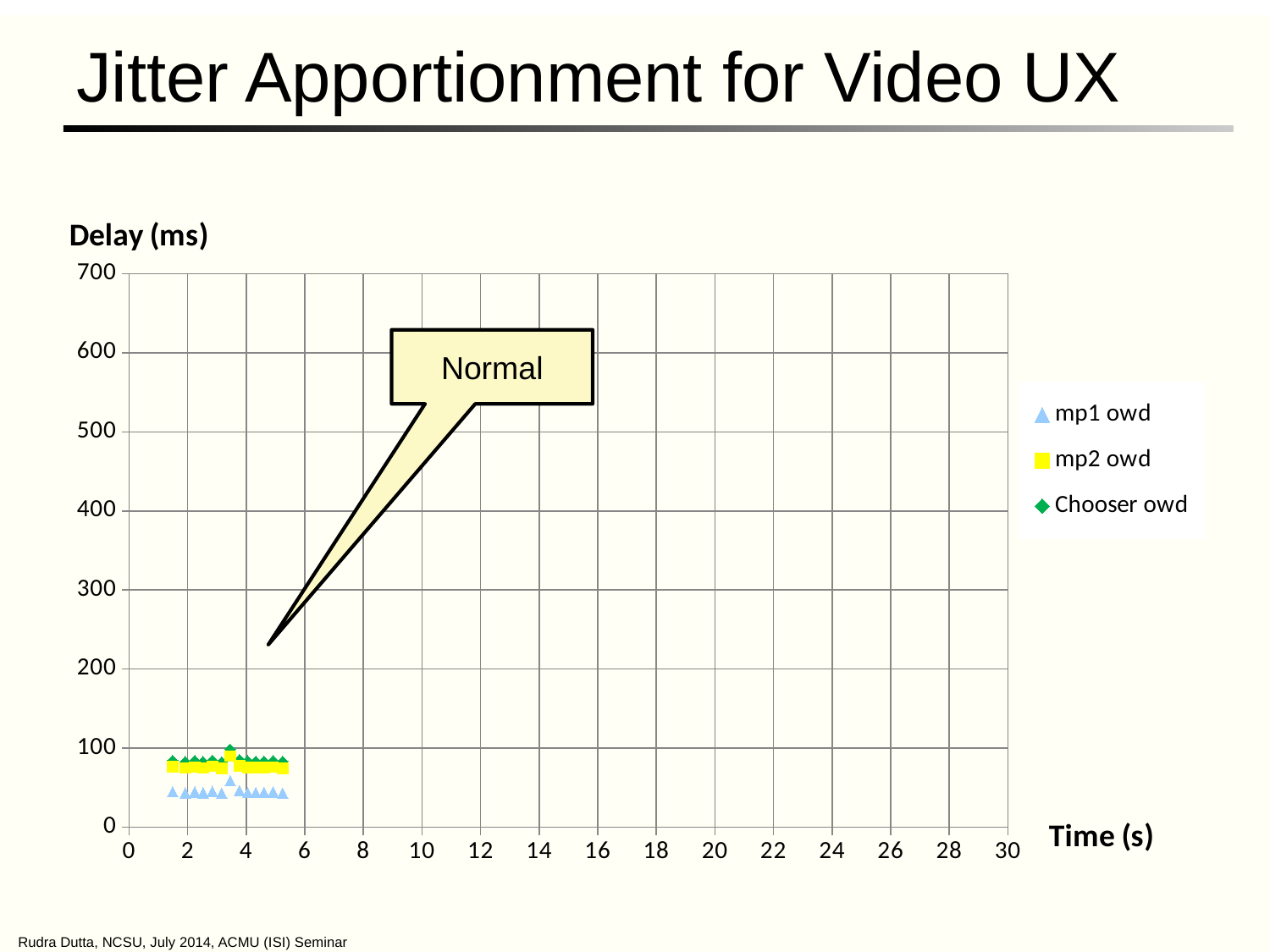
Which series has the higher delay values, Chooser owd or mp1 owd? Chooser owd How many series does the legend list? 3 What is the highest value shown on the Delay (ms) axis? 700 Are the mp1 owd values greater or less than 200 ms? less What are the three series named in the legend? mp1 owd, mp2 owd, Chooser owd Which series has the lowest delay values on the chart? mp1 owd What kind of chart is shown on the slide? scatter chart Do the plotted delay values rise, fall, or stay roughly flat over time? stay roughly flat What is the label on the vertical axis of the chart? Delay (ms) Which series has the highest delay values on the chart? Chooser owd Are the mp1 owd values greater or less than 100 ms? less Are the mp2 owd values greater or less than 100 ms? less